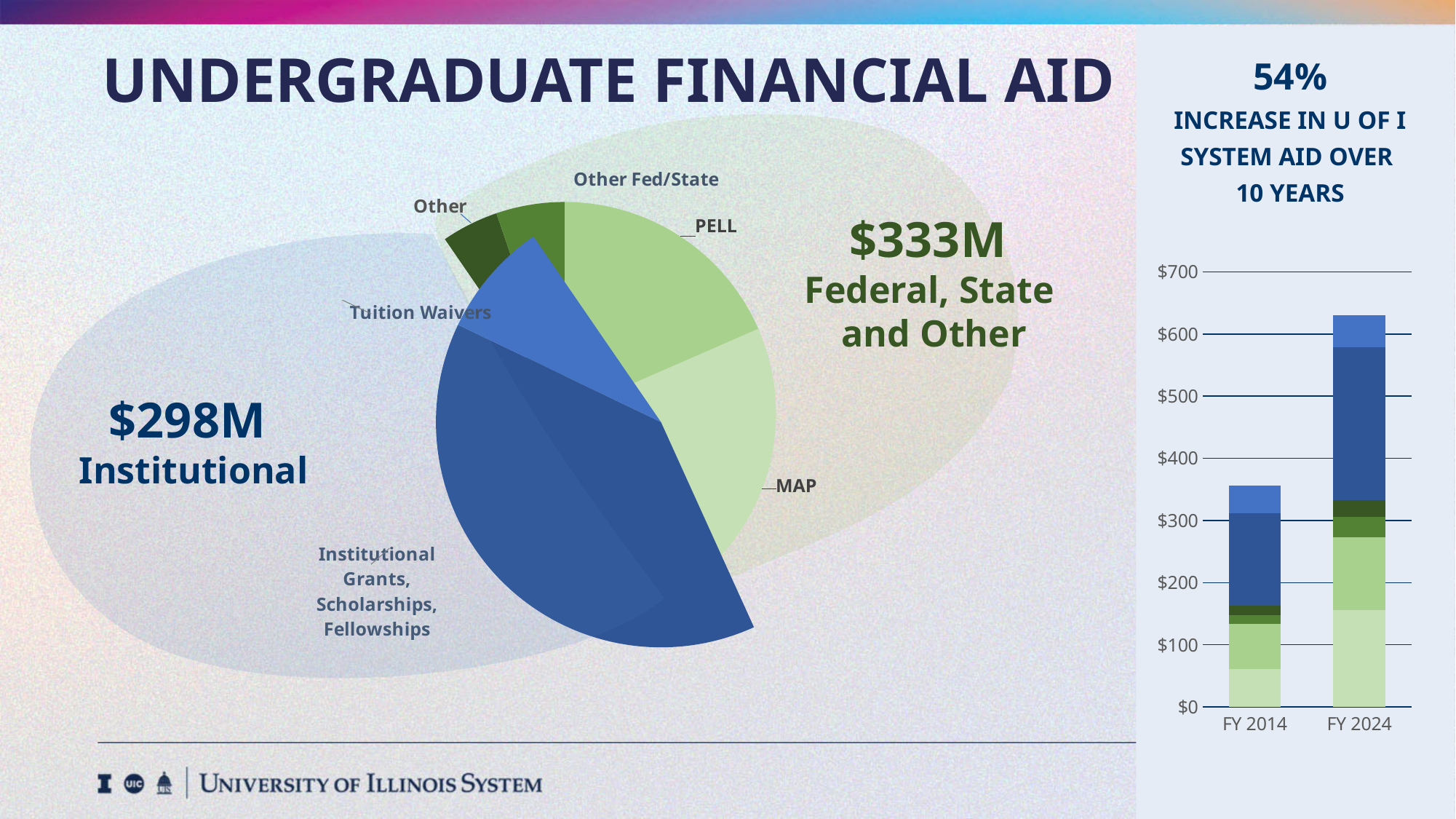
What kind of chart is the chart on the left side of the slide? pie chart What is the highest value shown on the vertical axis of the stacked bar chart on the right? $700 In the stacked bar chart on the right, is the total for FY 2014 greater or less than $400? less In the pie chart, which slice is larger, MAP or Tuition Waivers? MAP What kind of chart is the chart on the right side of the slide, below the '54%' text? bar chart In the pie chart, which slice is larger, PELL or Other Fed/State? PELL In the stacked bar chart on the right, is the total for FY 2024 greater or less than $600? greater How many slices does the pie chart have? 6 Which slice of the pie chart is the smallest? Other How many bars does the stacked bar chart on the right have? 2 In the stacked bar chart on the right, which year has the taller bar, FY 2014 or FY 2024? FY 2024 Which slice of the pie chart is the largest? Institutional Grants, Scholarships, Fellowships